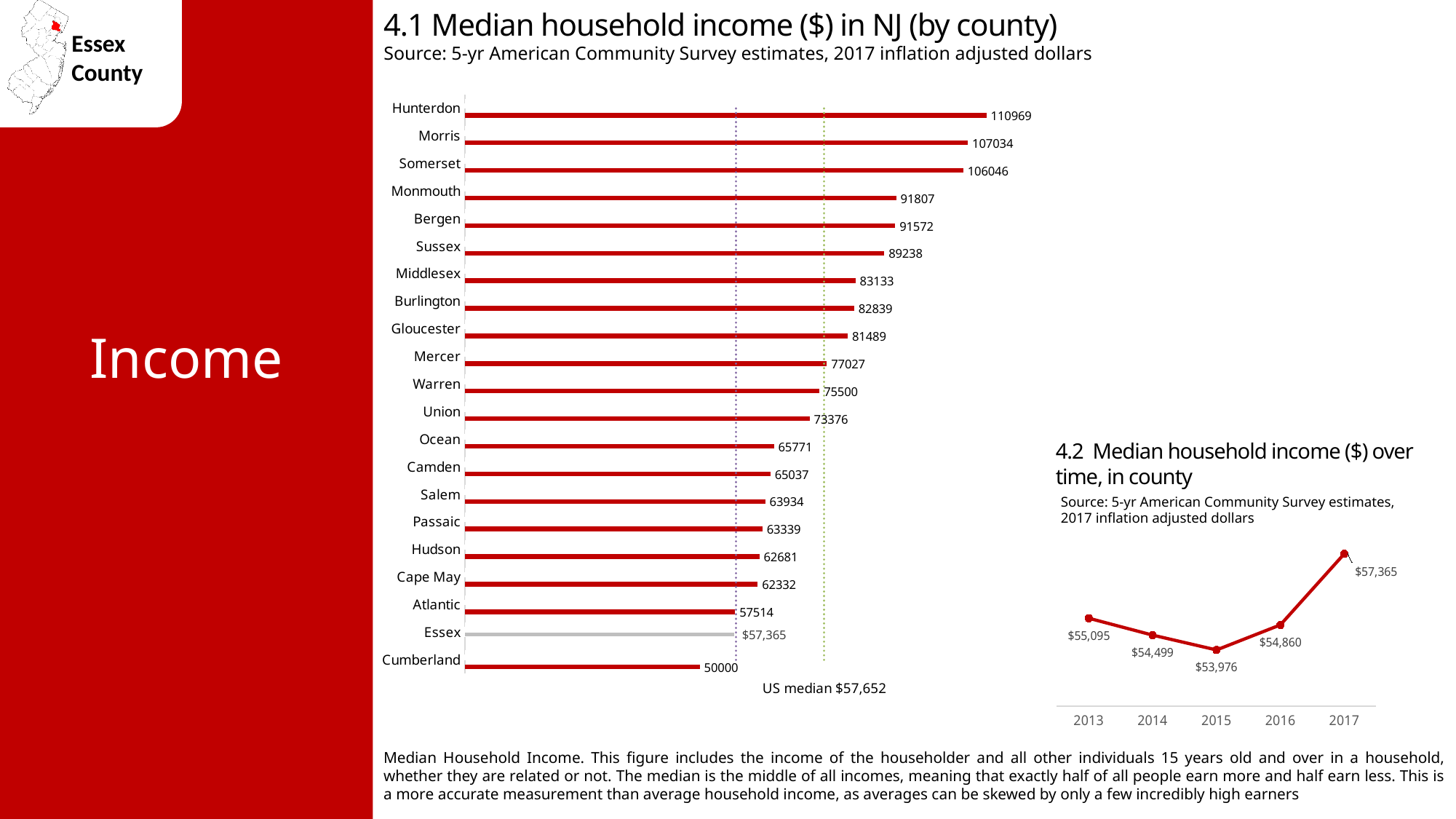
In chart 4.1 Median household income in NJ by county, how many counties are plotted? 21 In chart 4.1 Median household income in NJ by county, which county has the lowest median household income? Cumberland In chart 4.1 Median household income in NJ by county, what is the median household income for Hunterdon? 110969 In chart 4.1 Median household income in NJ by county, which county has the highest median household income? Hunterdon In chart 4.2 Median household income over time in county, how many years are plotted? 5 In chart 4.2 Median household income over time in county, what is the value for 2015? $53,976 In chart 4.2 Median household income over time in county, which year has the highest value? 2017 In chart 4.1 Median household income in NJ by county, what is the difference between Hunterdon's and Cumberland's values? 60969 In chart 4.1 Median household income in NJ by county, which has a higher median household income, Bergen or Monmouth? Monmouth In chart 4.2 Median household income over time in county, what is the difference between the 2017 and 2013 values? $2,270 In chart 4.1 Median household income in NJ by county, what is the value shown for Essex? $57,365 What type of chart is chart 4.1 Median household income in NJ by county? Bar chart